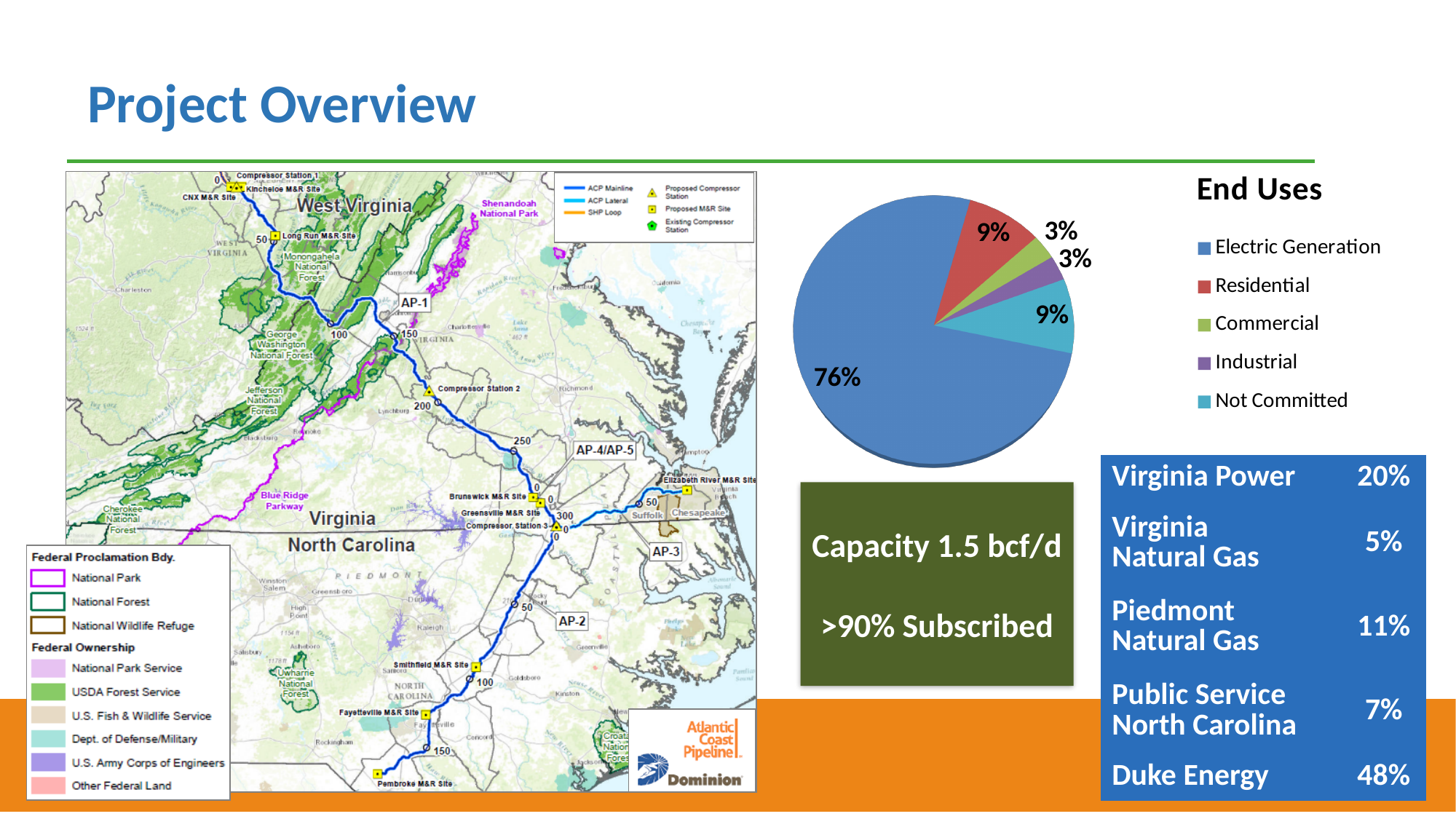
In the End Uses pie chart, what share is Not Committed? 9% In the End Uses pie chart, which is larger, Electric Generation or Residential? Electric Generation Which category has the largest slice in the End Uses pie chart? Electric Generation In the End Uses pie chart, which is larger, Not Committed or Industrial? Not Committed What kind of chart is the End Uses chart? pie chart In the End Uses pie chart, what share is Industrial? 3% In the End Uses pie chart, what share is Commercial? 3% In the End Uses pie chart, what share is Residential? 9% In the End Uses pie chart, what share is Electric Generation? 76% In the End Uses pie chart, what is the difference between the Electric Generation share and the Residential share? 67% What colour is the Not Committed slice in the End Uses pie chart? teal How many categories does the End Uses pie chart legend list? 5